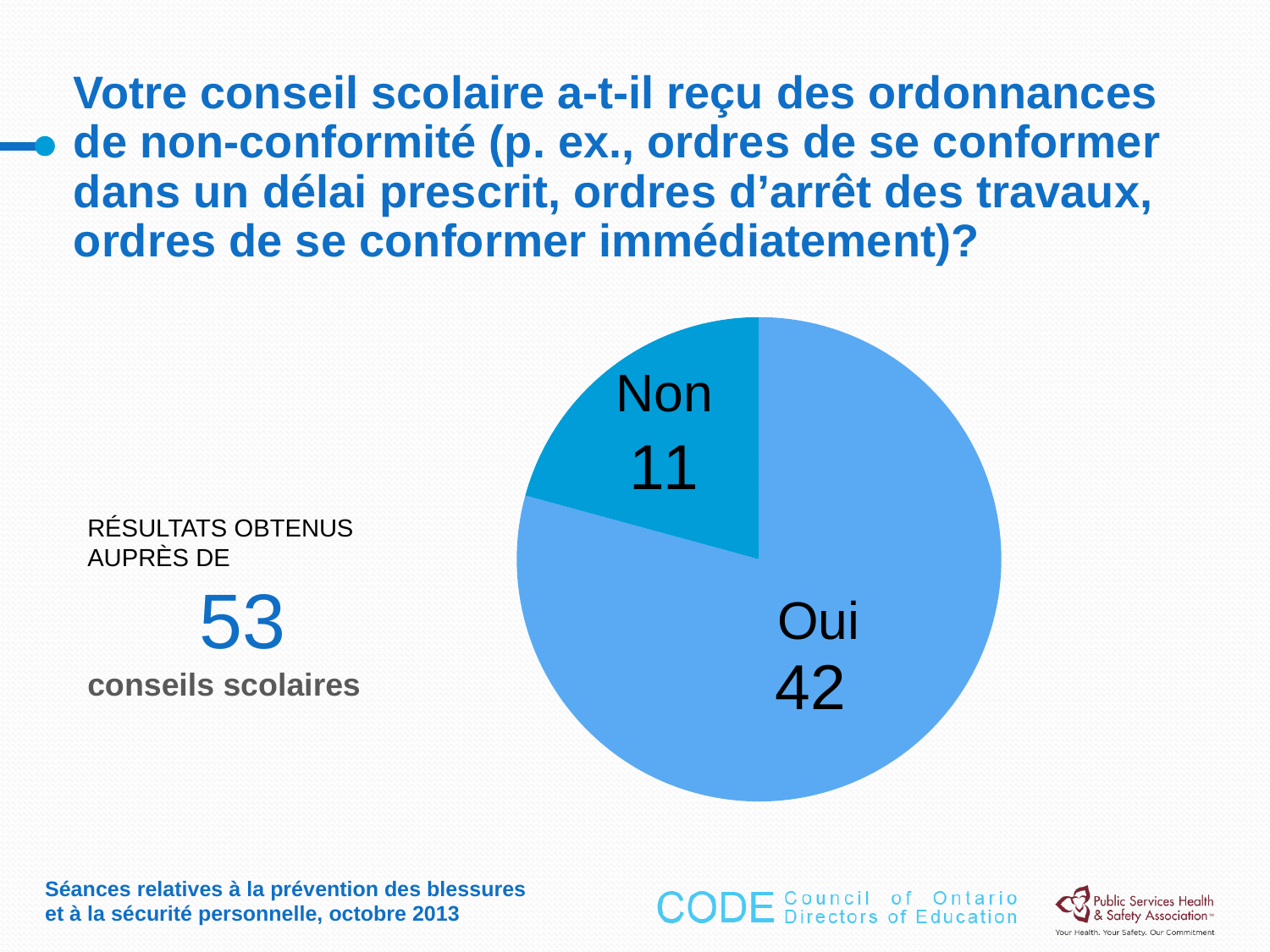
What share of the 53 responses in the pie chart is "Oui"? 42 out of 53 Which slice of the pie chart is the largest? Oui How many school boards answered "Non" in the pie chart? 11 How many school boards answered "Oui" in the pie chart? 42 Which is larger in the pie chart, "Oui" or "Non"? Oui What is the difference between the "Oui" and "Non" values in the pie chart? 31 How many slices does the pie chart have? 2 How many school boards does the slide say the results were obtained from? 53 Which slice of the pie chart is shown in the darker blue colour? Non What is the total of the two slices in the pie chart? 53 What type of chart is shown on the slide? pie chart Which slice of the pie chart is the smallest? Non